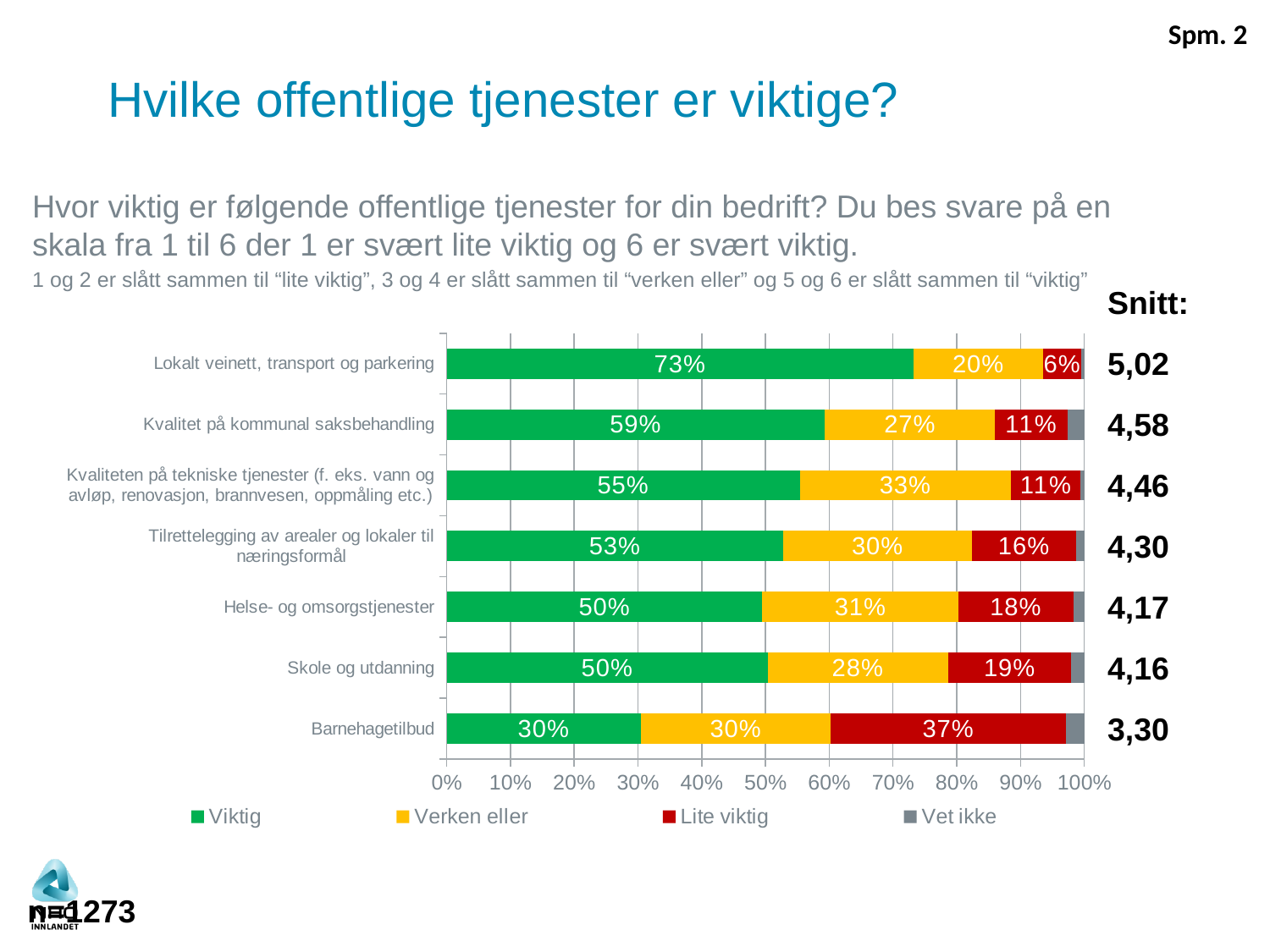
What is the Verken eller share for "Kvaliteten på tekniske tjenester (f. eks. vann og avløp, renovasjon, brannvesen, oppmåling etc.)"? 33% What type of chart is shown on the slide? Stacked bar chart How many public service categories are shown in the chart? 7 How many series does the legend list? 4 Which category has the highest Viktig share? Lokalt veinett, transport og parkering What is the Snitt (average) value shown for Barnehagetilbud? 3,30 Which category has the lowest Viktig share? Barnehagetilbud What is the Lite viktig share for Barnehagetilbud? 37% Which has the larger Verken eller share: "Kvalitet på kommunal saksbehandling" or "Helse- og omsorgstjenester"? Helse- og omsorgstjenester How many percentage points higher is the Viktig share for "Lokalt veinett, transport og parkering" than for "Kvalitet på kommunal saksbehandling"? 14 percentage points What percentage of respondents rated "Lokalt veinett, transport og parkering" as Viktig? 73% Which category has the highest Lite viktig share? Barnehagetilbud